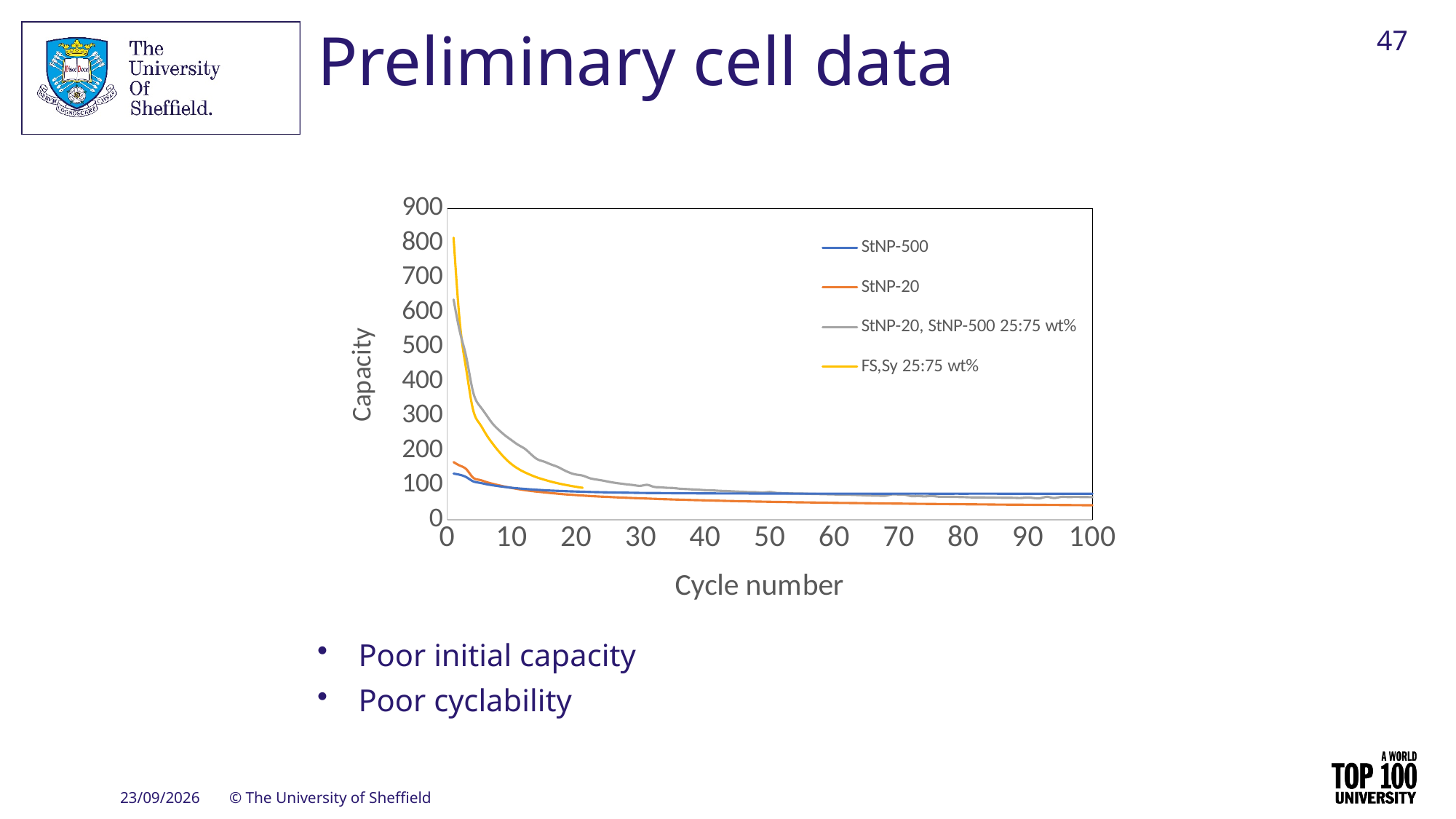
Which series has the highest capacity at cycle 1? FS,Sy 25:75 wt% Is the capacity of StNP-20 at cycle 100 greater or less than 100? less At cycle 100, which series has the larger capacity: StNP-500 or StNP-20? StNP-500 Is the capacity of FS,Sy 25:75 wt% at cycle 1 greater or less than 700? greater How many series does the chart legend list? 4 At cycle 1, which series has the larger capacity: StNP-20, StNP-500 25:75 wt% or StNP-20? StNP-20, StNP-500 25:75 wt% Is the capacity of StNP-500 at cycle 1 greater or less than 200? less What is the label of the y axis of the chart? Capacity Do the capacity values rise or fall as the cycle number increases? Fall What is the label of the x axis of the chart? Cycle number What kind of chart is shown on the slide? Line chart Which series has the lowest capacity at cycle 100? StNP-20